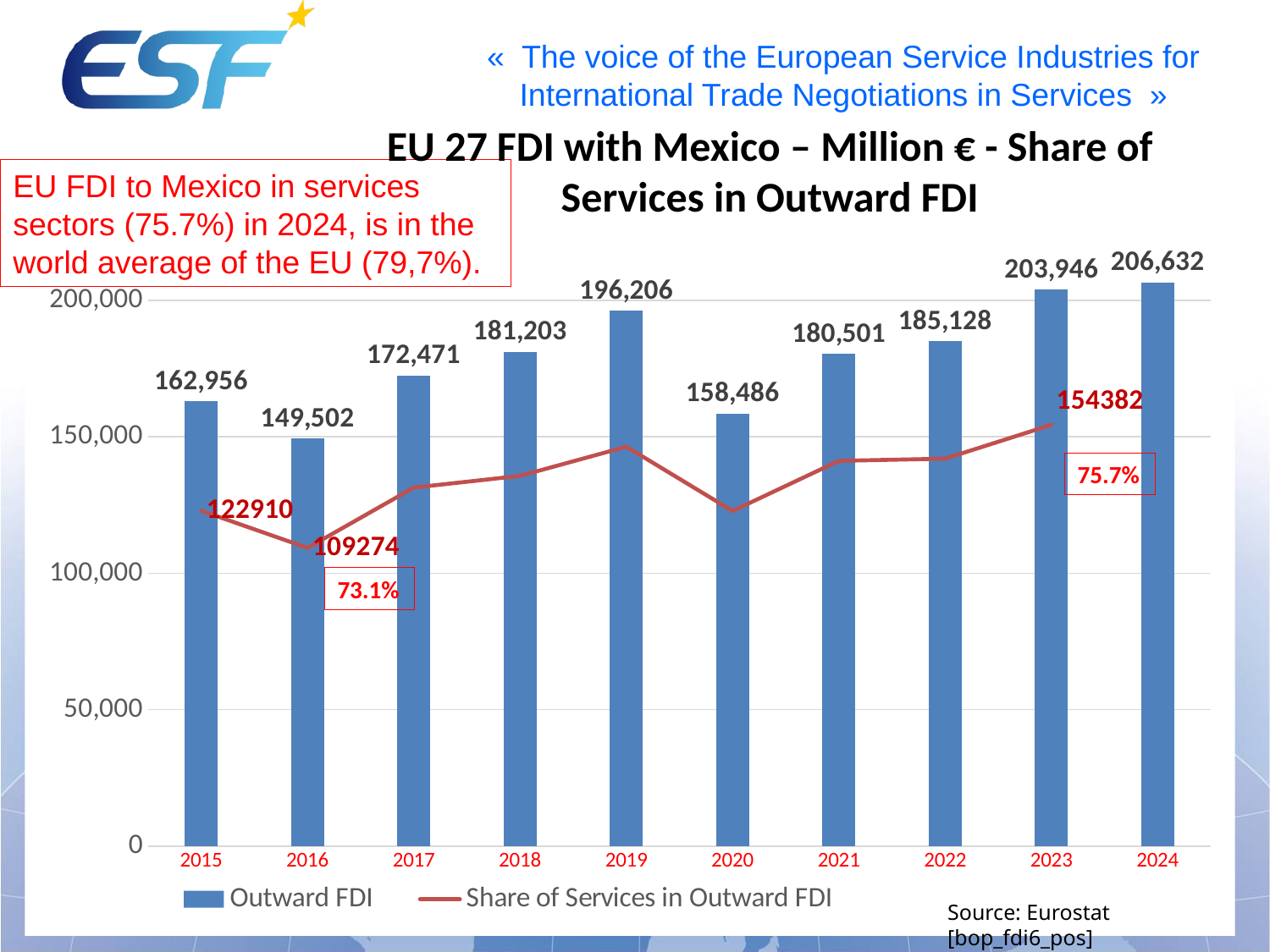
Which is larger, the Outward FDI for 2020 or for 2021? 2021 What is the Outward FDI value for 2019? 196,206 Which year has the highest Outward FDI? 2024 Which year has the lowest Outward FDI? 2016 Is the Share of Services in Outward FDI line value for 2020 greater or less than 150,000? less What is the difference between the Outward FDI values for 2024 and 2023? 2,686 What is the title of the chart? EU 27 FDI with Mexico – Million € - Share of Services in Outward FDI What kind of chart is used for the Outward FDI series? bar chart How many series does the legend list? 2 How many years are shown on the x axis? 10 What is the Outward FDI value for 2016? 149,502